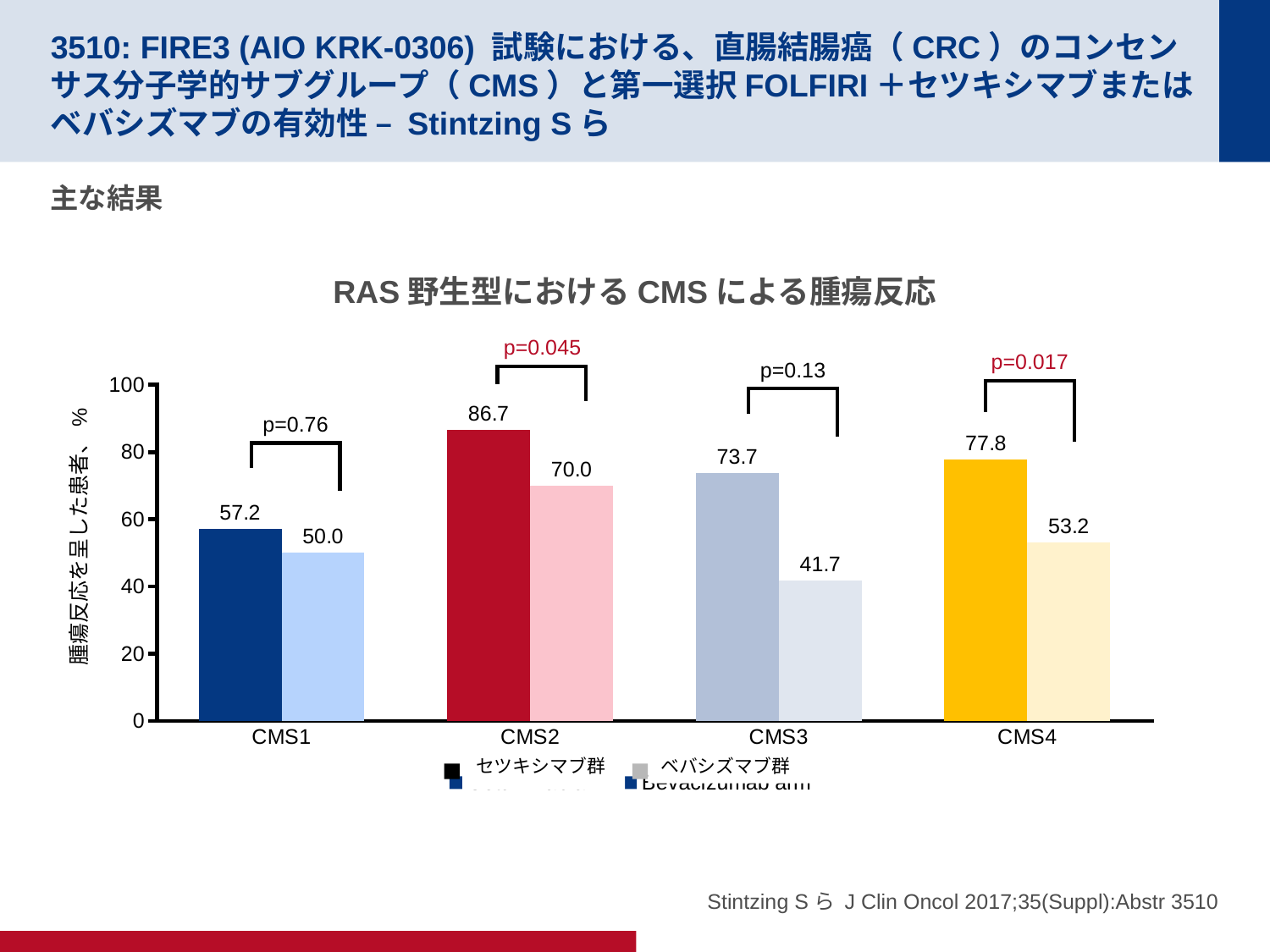
What is the value for the ベバシズマブ群 in CMS3? 41.7 What is the difference between the セツキシマブ群 and ベバシズマブ群 values in CMS3? 32.0 Which CMS group has the highest value for the セツキシマブ群? CMS2 Which CMS group has the lowest value for the ベバシズマブ群? CMS3 What kind of chart is shown on the slide? Bar chart Which is larger in CMS4: the セツキシマブ群 value or the ベバシズマブ群 value? セツキシマブ群 What p-value is shown above the CMS2 bars? p=0.045 How many series does the legend list? 2 What is the value for the ベバシズマブ群 in CMS1? 50.0 What is the value for the セツキシマブ群 in CMS2? 86.7 How many CMS categories are shown on the x axis? 4 What is the value for the セツキシマブ群 in CMS4? 77.8